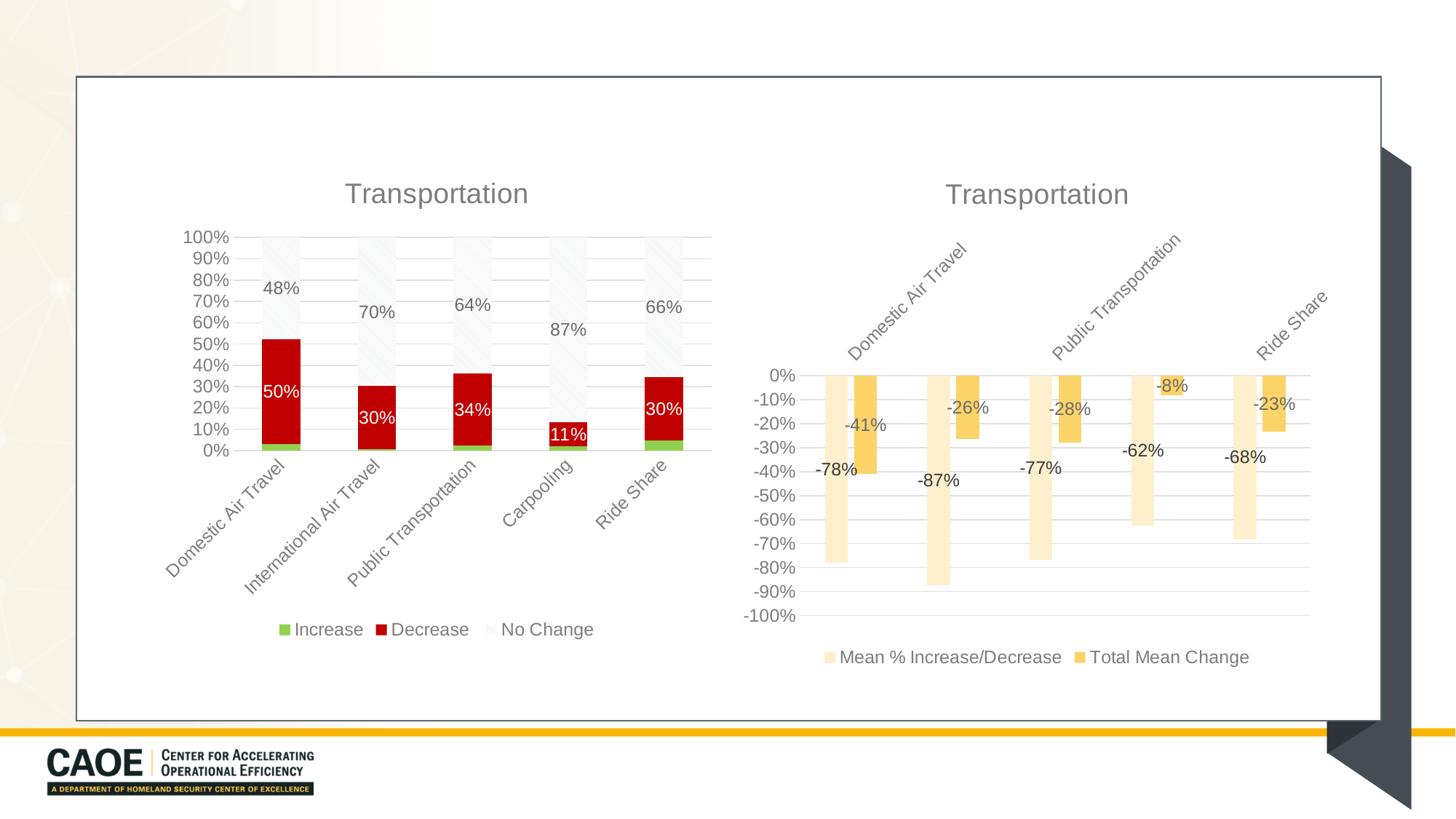
What kind of chart is the left chart? Stacked bar chart In the right chart, what is the Mean % Increase/Decrease value for Public Transportation? -77% In the left chart, what is the Decrease value for Domestic Air Travel? 50% In the left chart, how many categories are shown on the x axis? 5 In the right chart, how many series does the legend list? 2 In the right chart, what is the Total Mean Change value for Ride Share? -23% In the left chart, which category has the highest Decrease value? Domestic Air Travel In the left chart, what is the difference between the No Change values for Carpooling and Domestic Air Travel? 39% In the left chart, what is the No Change value for Carpooling? 87% In the right chart, which is larger in magnitude, the Total Mean Change for Domestic Air Travel or for Ride Share? Domestic Air Travel In the left chart, which category has the lowest Decrease value? Carpooling In the left chart, how many series does the legend list? 3